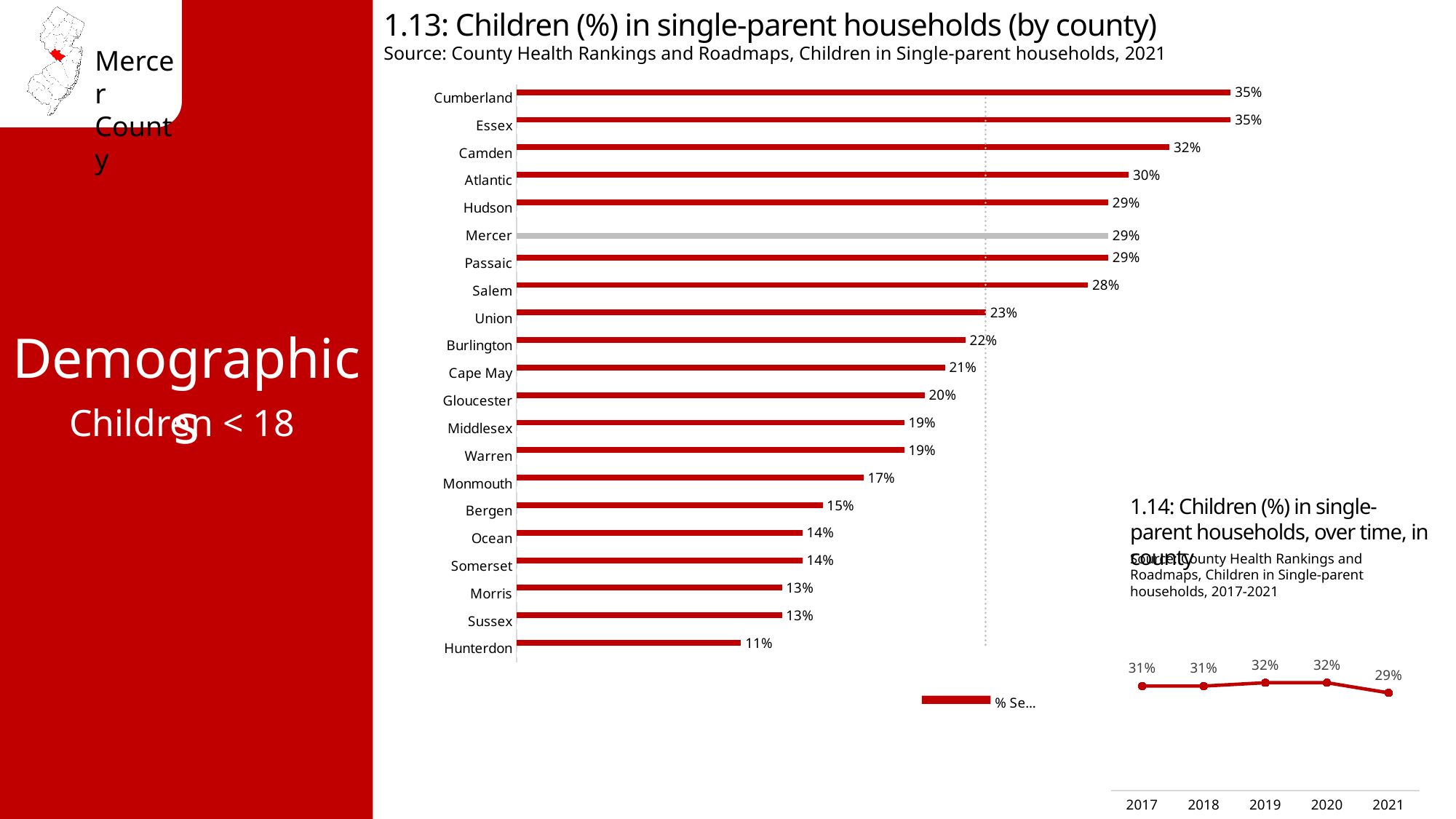
In chart 1.13 (by county), what is the value for Hunterdon? 11% In chart 1.14 (Children (%) in single-parent households over time), what is the value for 2021? 29% In chart 1.14 (over time), which year has the lowest value? 2021 In chart 1.14 (over time), how many years are plotted? 5 In chart 1.13 (by county), how many counties are shown? 21 In chart 1.14 (over time), what is the difference between the values for 2020 and 2021? 3 percentage points In chart 1.13 (Children (%) in single-parent households by county), what is the value for Mercer? 29% In chart 1.13 (by county), what is the value for Salem? 28% In chart 1.13 (by county), which county has the lowest percentage of children in single-parent households? Hunterdon What kind of chart is chart 1.13 (Children (%) in single-parent households by county)? Bar chart In chart 1.13 (by county), which is larger, the value for Camden or the value for Union? Camden In chart 1.13 (by county), what is the difference between the values for Cumberland and Hunterdon? 24 percentage points